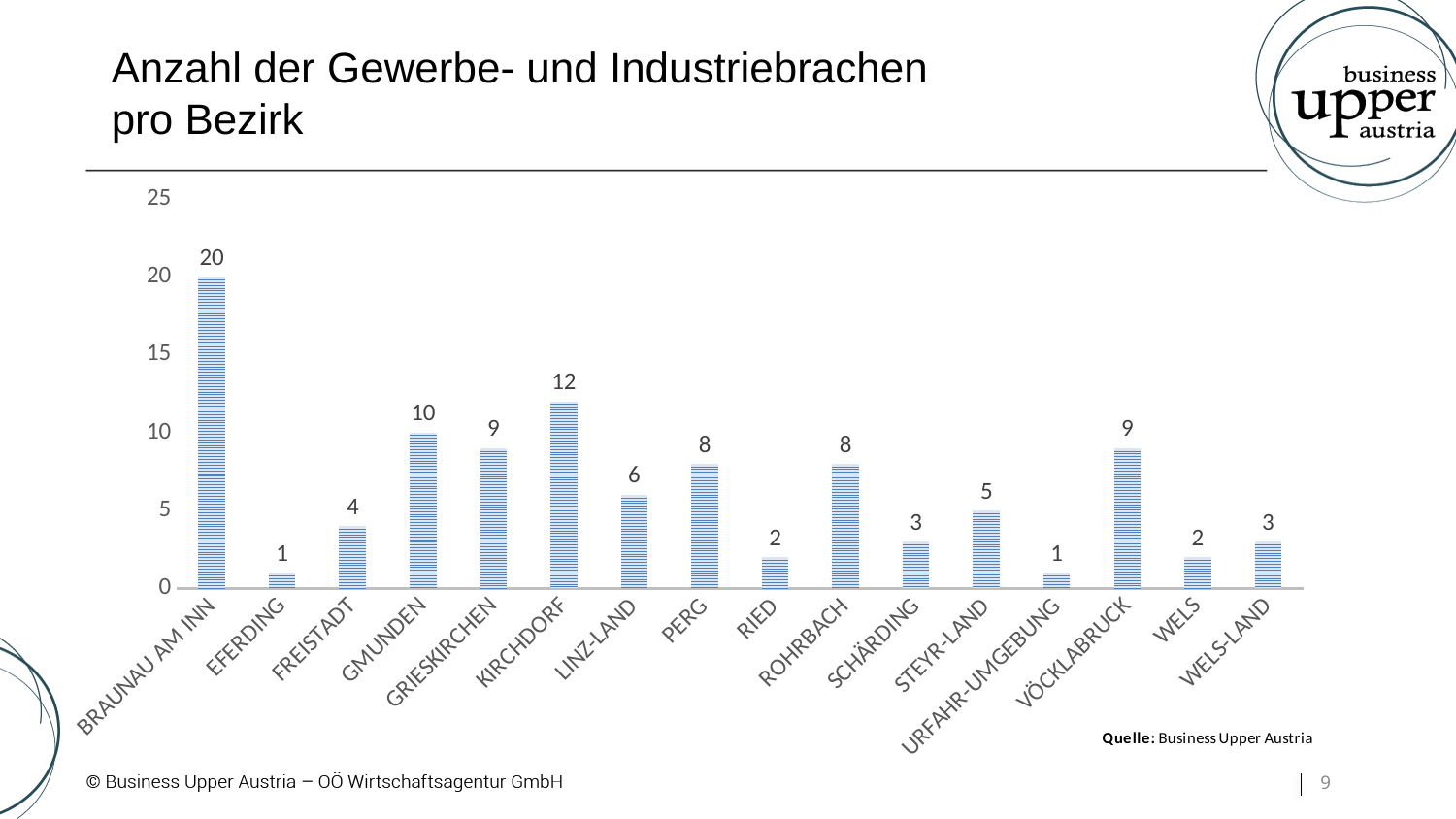
What is the value for GMUNDEN? 10 Which district has the highest number of Gewerbe- und Industriebrachen? BRAUNAU AM INN What kind of chart is shown on the slide? bar chart What is the title of the chart on the slide? Anzahl der Gewerbe- und Industriebrachen pro Bezirk Which is larger, the value for PERG or the value for SCHÄRDING? PERG What is the difference between the values for BRAUNAU AM INN and KIRCHDORF? 8 Is the value for BRAUNAU AM INN greater or less than 15? greater What is the value for STEYR-LAND? 5 What is the value for KIRCHDORF? 12 What is the difference between the values for GRIESKIRCHEN and LINZ-LAND? 3 Which is larger, the value for FREISTADT or the value for VÖCKLABRUCK? VÖCKLABRUCK How many districts are shown on the x axis? 16